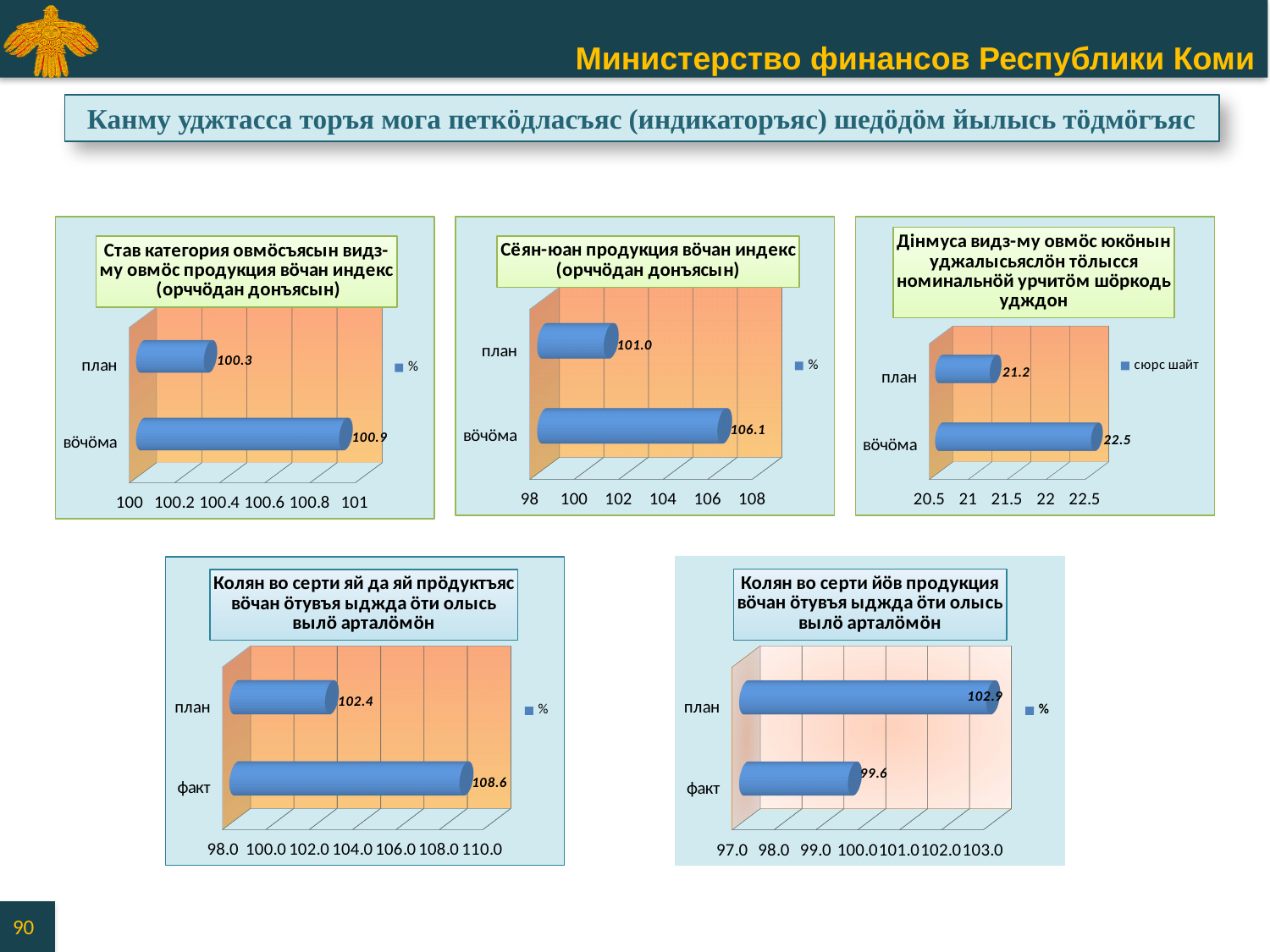
In the top-left chart (Став категория овмӧсъясын видз-му овмӧс продукция вӧчан индекс), what is the value for план? 100.3 In the top-right chart (Дінмуса видз-му овмӧс юкӧнын ... шӧркодь удждон), what unit does the legend show? сюрс шайт In the bottom-right chart (Колян во серти йӧв продукция ...), which category has the lower value? факт In the bottom-left chart (Колян во серти яй да яй прӧдуктъяс ...), what is the value for факт? 108.6 In the top-middle chart (Сёян-юан продукция вӧчан индекс), what is the difference between вӧчӧма and план? 5.1 In the top-right chart (Дінмуса видз-му овмӧс юкӧнын ... шӧркодь удждон), what is the value for план? 21.2 In the bottom-left chart (Колян во серти яй да яй прӧдуктъяс ...), what is the difference between факт and план? 6.2 In the top-left chart (Став категория овмӧсъясын видз-му овмӧс продукция вӧчан индекс), what is the value for вӧчӧма? 100.9 What type of chart is the bottom-right chart (Колян во серти йӧв продукция ...)? bar chart In the bottom-right chart (Колян во серти йӧв продукция ...), what is the value for план? 102.9 In the top-right chart (Дінмуса видз-му овмӧс юкӧнын ... шӧркодь удждон), which category has the higher value, план or вӧчӧма? вӧчӧма In the top-middle chart (Сёян-юан продукция вӧчан индекс), what is the value for вӧчӧма? 106.1